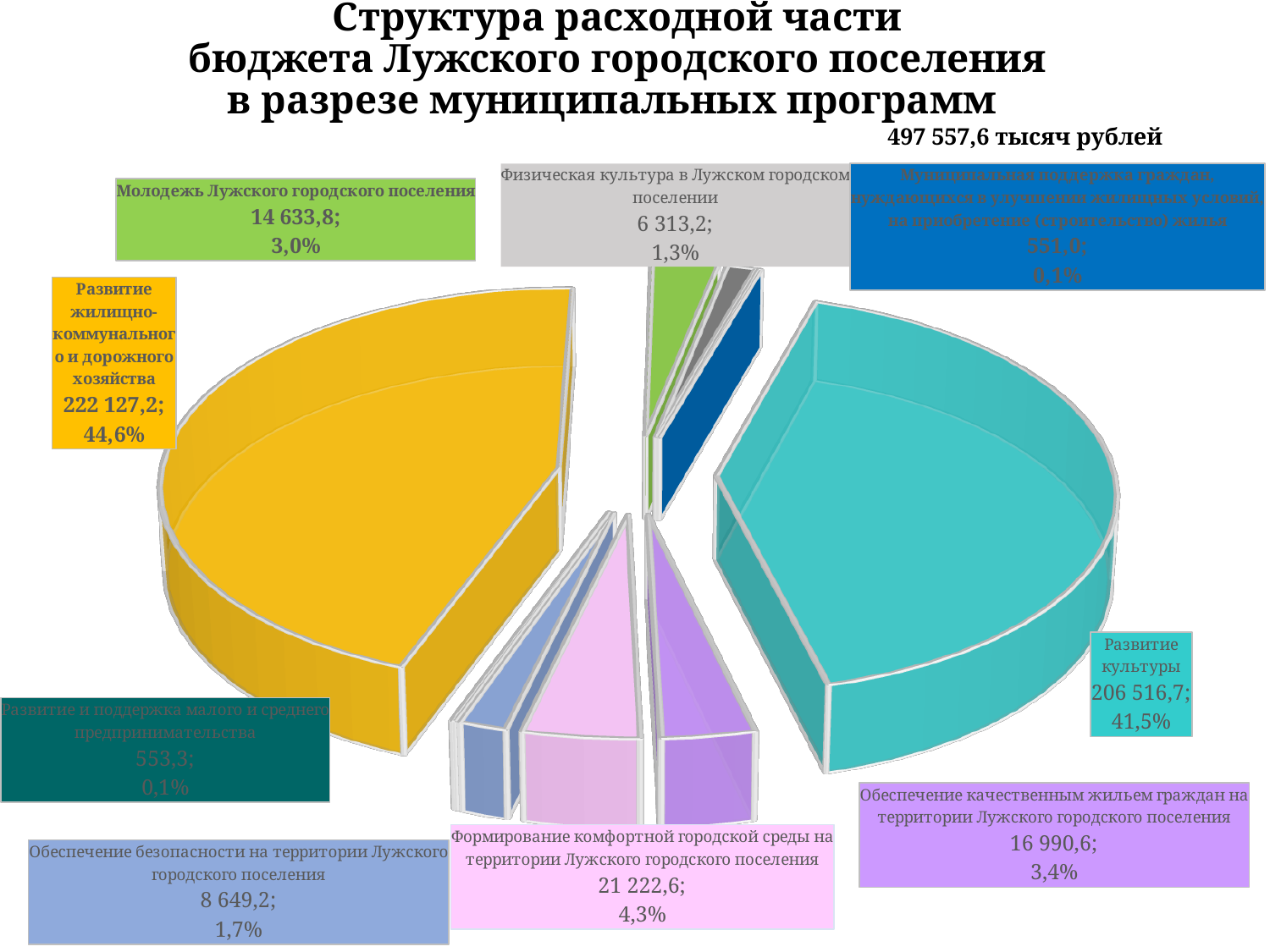
What kind of chart is shown on the slide? pie chart What is the value for Развитие культуры? 206 516,7 What is the difference between the values for Развитие жилищно-коммунального и дорожного хозяйства and Развитие культуры? 15 610,5 What is the value for Физическая культура в Лужском городском поселении? 6 313,2 What share of the pie does Обеспечение безопасности на территории Лужского городского поселения take? 1,7% What share of the pie does Молодежь Лужского городского поселения take? 3,0% What share of the pie does Развитие жилищно-коммунального и дорожного хозяйства take? 44,6% Which is larger: the value for Молодежь Лужского городского поселения or the value for Обеспечение качественным жильем граждан на территории Лужского городского поселения? Обеспечение качественным жильем граждан на территории Лужского городского поселения What total amount is stated for the budget expenditure shown in the chart? 497 557,6 тысяч рублей What is the value for Формирование комфортной городской среды на территории Лужского городского поселения? 21 222,6 How many programs (slices) are labelled in the pie chart? 9 Which program has the largest share of the pie? Развитие жилищно-коммунального и дорожного хозяйства